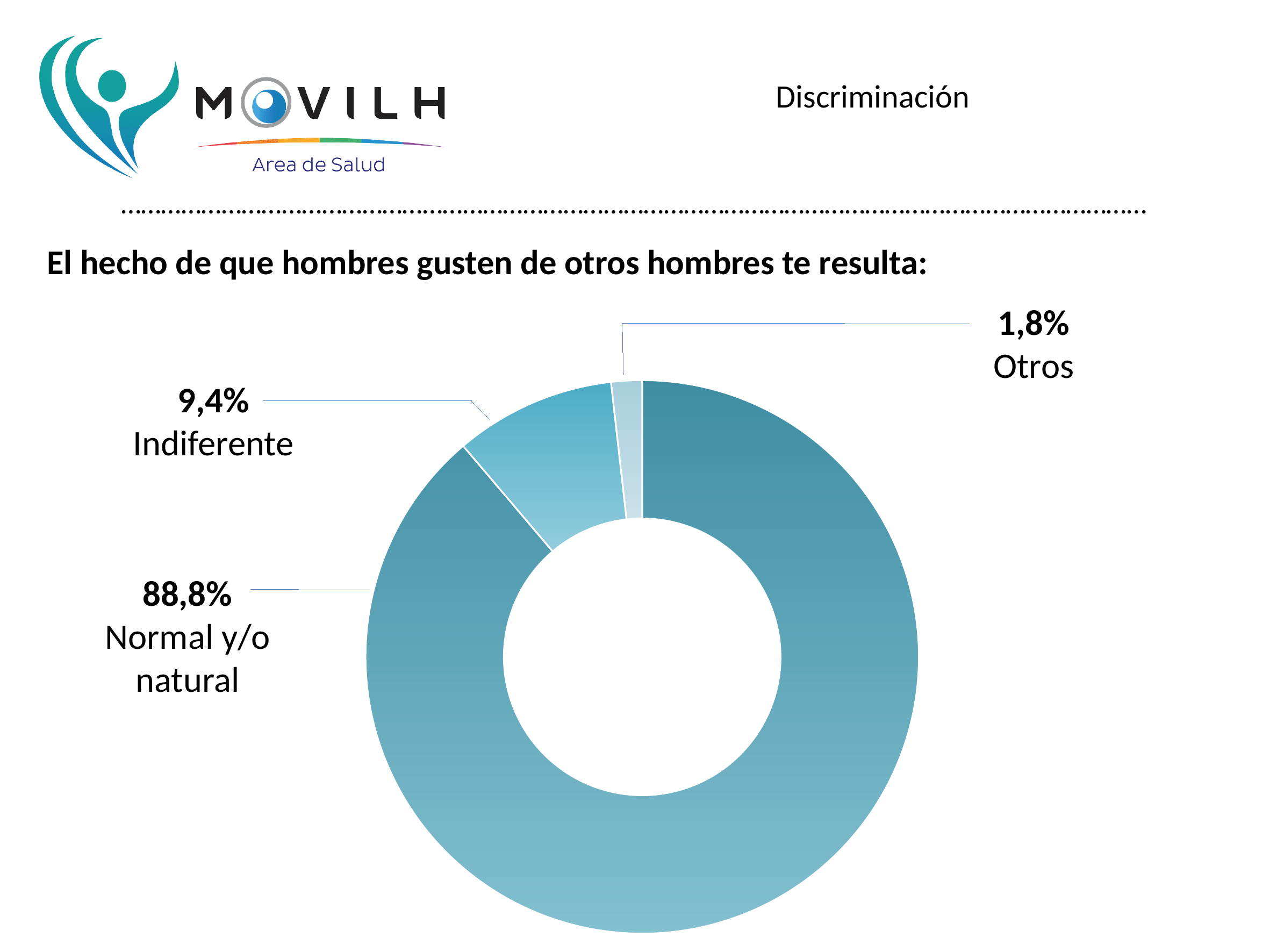
What is the section heading shown at the top right of the slide? Discriminación What percentage of respondents answered "Indiferente"? 9,4% What percentage of respondents answered "Normal y/o natural"? 88,8% Which category has the largest share of the chart? Normal y/o natural Which is larger, the share for "Indiferente" or the share for "Otros"? Indiferente What percentage of respondents answered "Otros"? 1,8% How many categories are shown in the chart? 3 What question does the chart title ask? El hecho de que hombres gusten de otros hombres te resulta: Which category has the smallest share of the chart? Otros What is the difference in percentage points between "Normal y/o natural" and "Indiferente"? 79,4 What is the difference in percentage points between "Indiferente" and "Otros"? 7,6 What kind of chart is shown on the slide? Doughnut (pie) chart